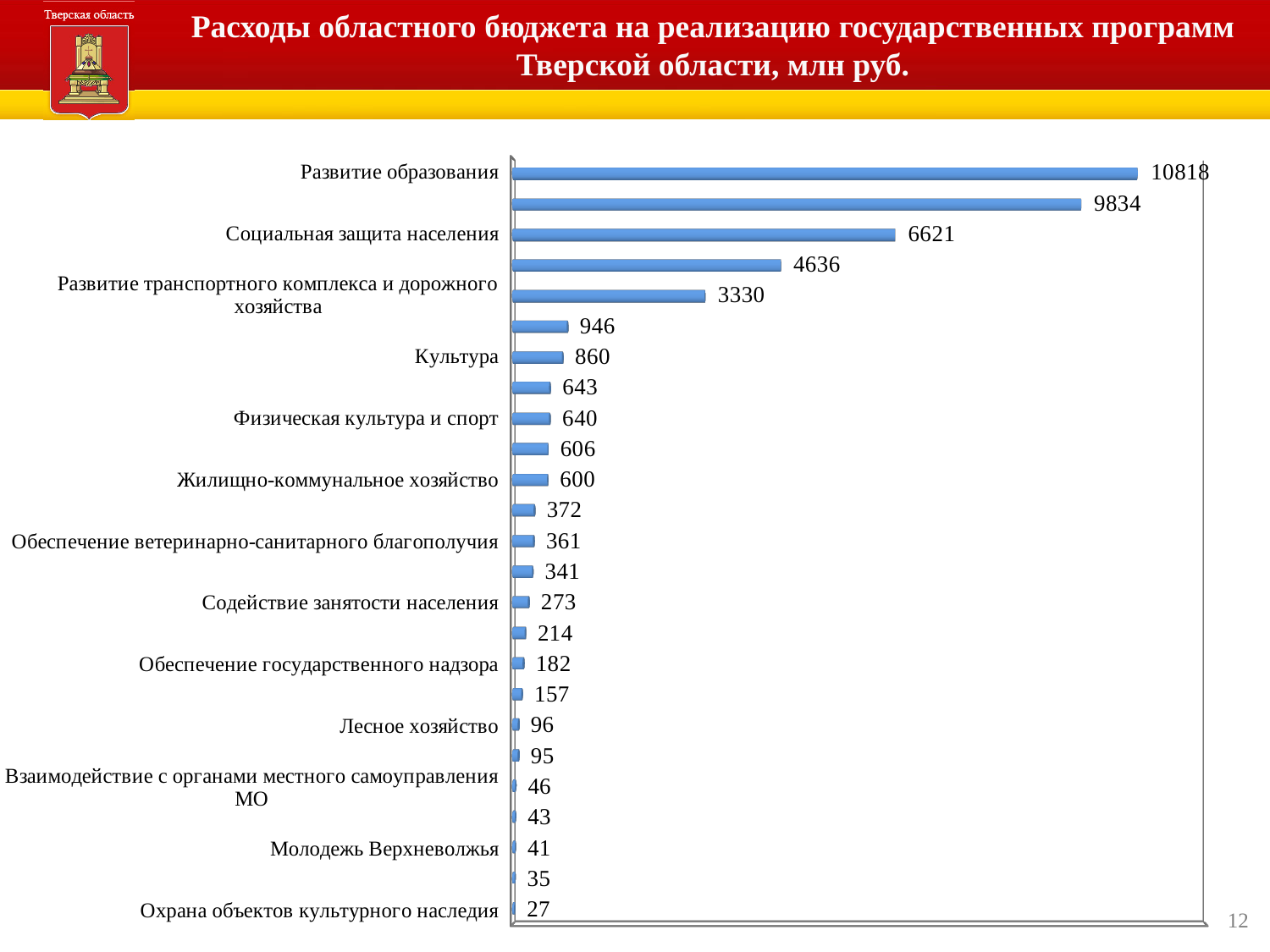
Which category has the highest value? Развитие образования What is the value for Развитие образования? 10818 Which is larger, the value for Физическая культура и спорт or the value for Жилищно-коммунальное хозяйство? Физическая культура и спорт What unit of measurement is stated in the chart title? млн руб. What is the value for Социальная защита населения? 6621 What is the value for Культура? 860 How many bars are plotted in the chart? 25 What is the difference between the values for Содействие занятости населения and Обеспечение государственного надзора? 91 What type of chart is shown on the slide? bar chart What is the difference between the values for Развитие образования and Социальная защита населения? 4197 Which category has the lowest value? Охрана объектов культурного наследия What is the value for Лесное хозяйство? 96